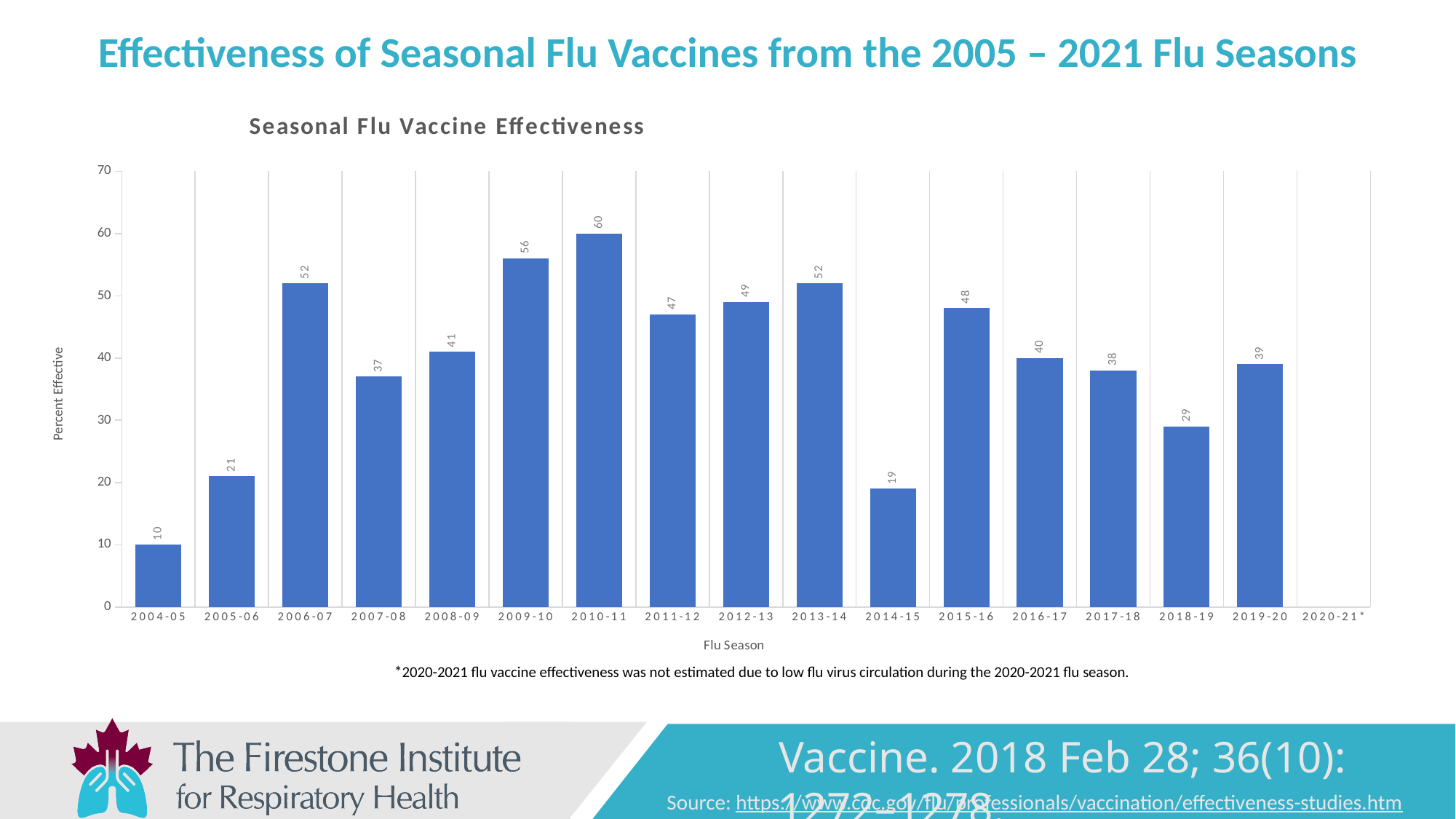
What is the vaccine effectiveness value for the 2010-11 flu season? 60 How many flu seasons have a bar plotted on the chart? 16 Is the vaccine effectiveness for the 2018-19 flu season greater or less than 30? less What is the title of the chart? Seasonal Flu Vaccine Effectiveness Which flu season has a higher vaccine effectiveness, 2012-13 or 2016-17? 2012-13 What is the label of the y-axis? Percent Effective What type of chart is shown on the slide? bar chart What is the vaccine effectiveness value for the 2014-15 flu season? 19 Which flu season has the lowest vaccine effectiveness? 2004-05 Which flu season has the highest vaccine effectiveness? 2010-11 What is the vaccine effectiveness value for the 2019-20 flu season? 39 What is the difference in vaccine effectiveness between the 2009-10 and 2005-06 flu seasons? 35